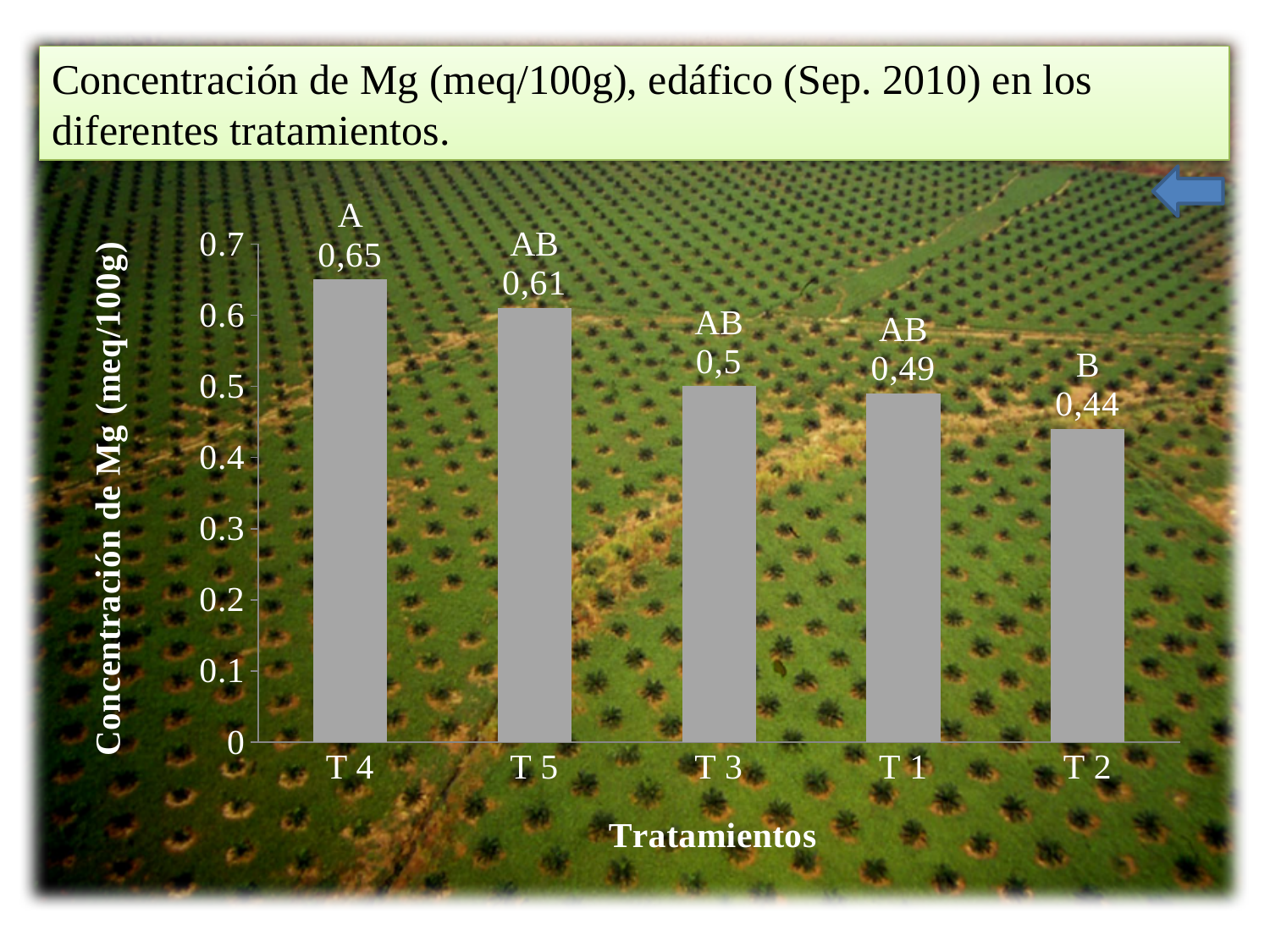
How many treatments are shown on the chart? 5 Which treatment has the lowest Mg concentration? T 2 What kind of chart is shown on the slide? bar chart What is the label of the x axis? Tratamientos What is the Mg concentration for treatment T 2? 0,44 What is the Mg concentration for treatment T 4? 0,65 Is the value for T 1 greater or less than 0.6? less What is the Mg concentration for treatment T 3? 0,5 What is the difference in Mg concentration between T 4 and T 2? 0,21 Which has a higher Mg concentration, T 5 or T 3? T 5 What is the difference in Mg concentration between T 5 and T 1? 0,12 Which treatment has the highest Mg concentration? T 4